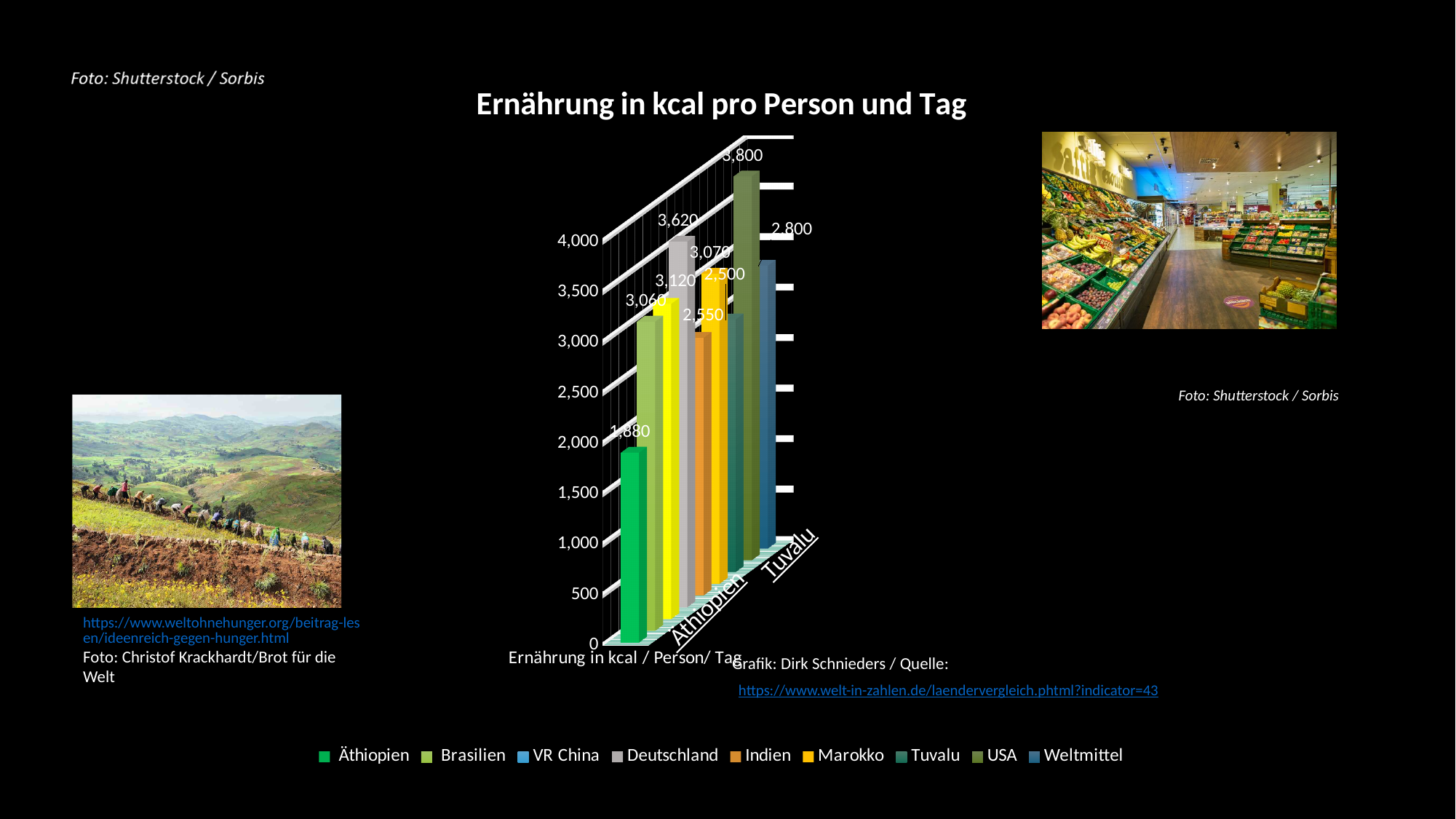
Is the value for Äthiopien greater or less than 2,000? less What is the value for USA? 3,800 What is the value for Brasilien? 3,060 How many series does the legend list? 9 Which country has the lowest value? Äthiopien Which country has the highest value? USA What is the value for Deutschland? 3,620 What is the difference between the values for USA and Äthiopien? 1,920 What is the title of the chart? Ernährung in kcal pro Person und Tag What is the value for Äthiopien? 1,880 What is the value for Weltmittel? 2,800 What kind of chart is shown on the slide? bar chart